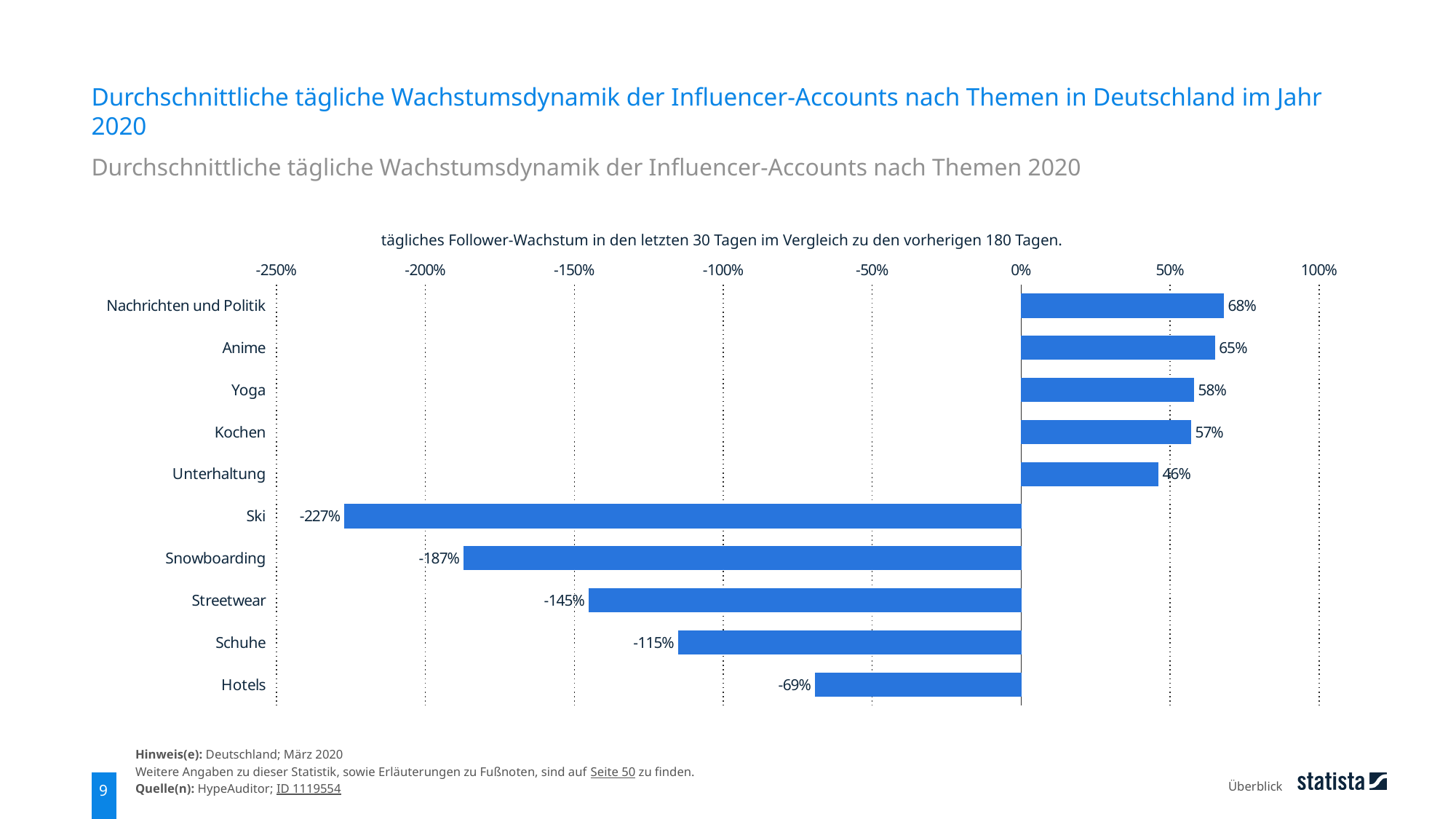
What is the difference between the values for Anime and Yoga? 7% Which has a larger value, Kochen or Unterhaltung? Kochen What is the value for Hotels? -69% What is the label of the x axis? tägliches Follower-Wachstum in den letzten 30 Tagen im Vergleich zu den vorherigen 180 Tagen. What is the value for Unterhaltung? 46% Which category has the highest value? Nachrichten und Politik What is the value for Nachrichten und Politik? 68% How many categories are shown in the chart? 10 What is the value for Ski? -227% What kind of chart is shown on the slide? bar chart What is the difference between the values for Snowboarding and Streetwear? 42% Which category has the lowest value? Ski